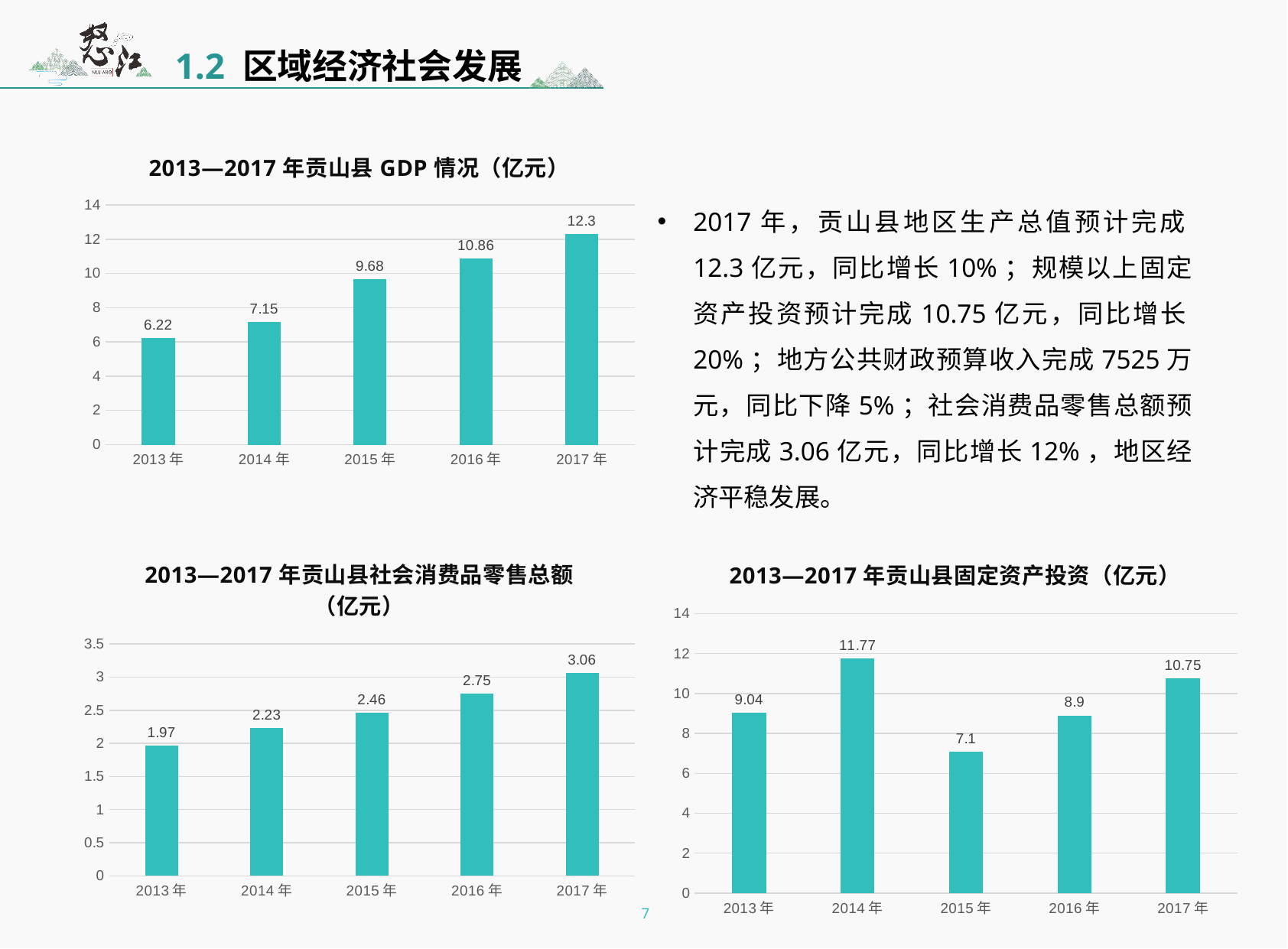
In the GDP chart (2013—2017 年贡山县 GDP 情况), what is the difference between the 2017 年 and 2013 年 values? 6.08 In the GDP chart (2013—2017 年贡山县 GDP 情况), what is the value for 2015 年? 9.68 In the retail sales chart (2013—2017 年贡山县社会消费品零售总额), which year has the lowest value? 2013 年 In the retail sales chart (2013—2017 年贡山县社会消费品零售总额), is the value for 2017 年 greater or less than 3? greater In the GDP chart (2013—2017 年贡山县 GDP 情况), which year has the highest value? 2017 年 In the retail sales chart (2013—2017 年贡山县社会消费品零售总额), what is the value for 2014 年? 2.23 In the fixed asset investment chart (2013—2017 年贡山县固定资产投资), which year has the highest value? 2014 年 In the retail sales chart (2013—2017 年贡山县社会消费品零售总额), how many years are plotted? 5 In the fixed asset investment chart (2013—2017 年贡山县固定资产投资), what is the value for 2016 年? 8.9 In the fixed asset investment chart (2013—2017 年贡山县固定资产投资), which is larger, the value for 2013 年 or 2015 年? 2013 年 In the GDP chart (2013—2017 年贡山县 GDP 情况), do the values rise or fall from 2013 年 to 2017 年? rise What type of chart is the fixed asset investment chart (2013—2017 年贡山县固定资产投资)? bar chart